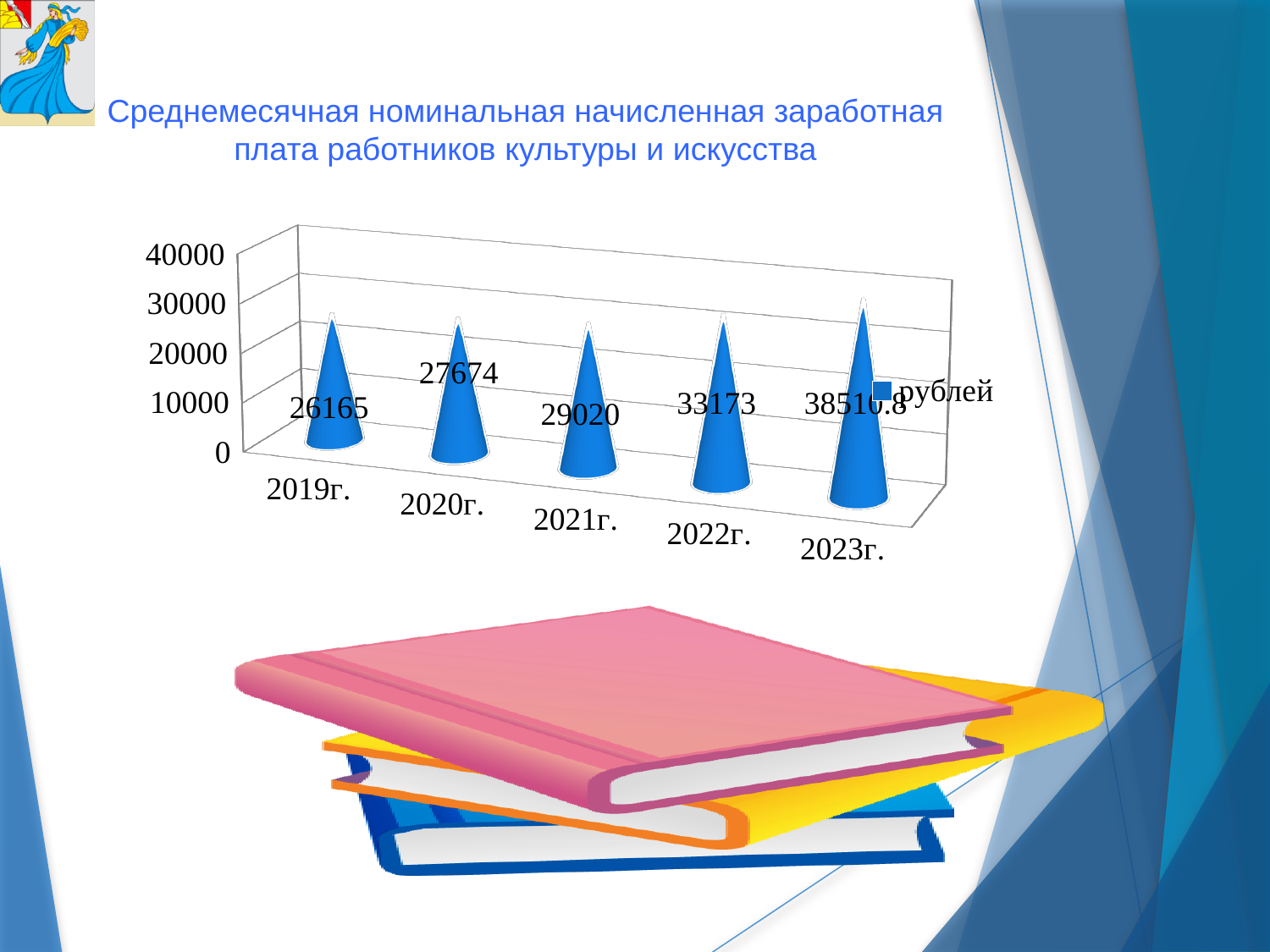
Do the values rise or fall from 2019г. to 2023г.? rise What is the value for 2022г.? 33173 Is the value for 2023г. greater or less than 30000? greater How many years are shown on the x axis? 5 What is the difference between the values for 2021г. and 2020г.? 1346 Which year has the highest value? 2023г. What is the value for 2020г.? 27674 What is the difference between the values for 2022г. and 2019г.? 7008 Which year has the lowest value? 2019г. What is the value for 2019г.? 26165 Which is larger, the value for 2022г. or the value for 2021г.? 2022г. What is the value for 2021г.? 29020